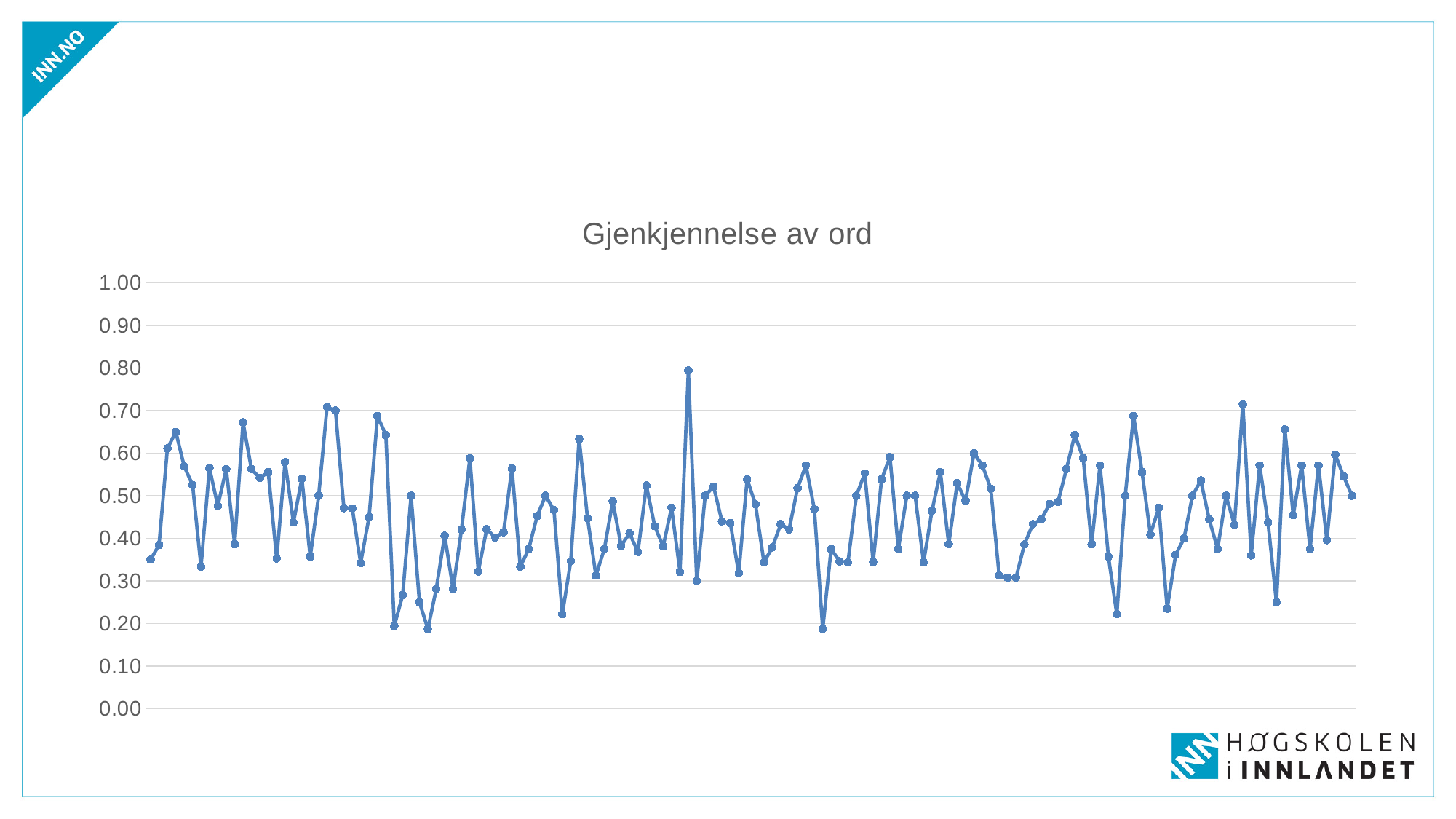
What is the highest value shown on the vertical axis of the chart? 1.00 Is the lowest point on the line greater or less than 0.30? less Is the lowest point on the line greater or less than 0.10? greater Is the first point of the line greater or less than 0.40? less What is the title of the chart? Gjenkjennelse av ord Does the line show a steady rise, a steady fall, or does it fluctuate along the x axis? fluctuates What kind of chart is shown on the slide? line chart